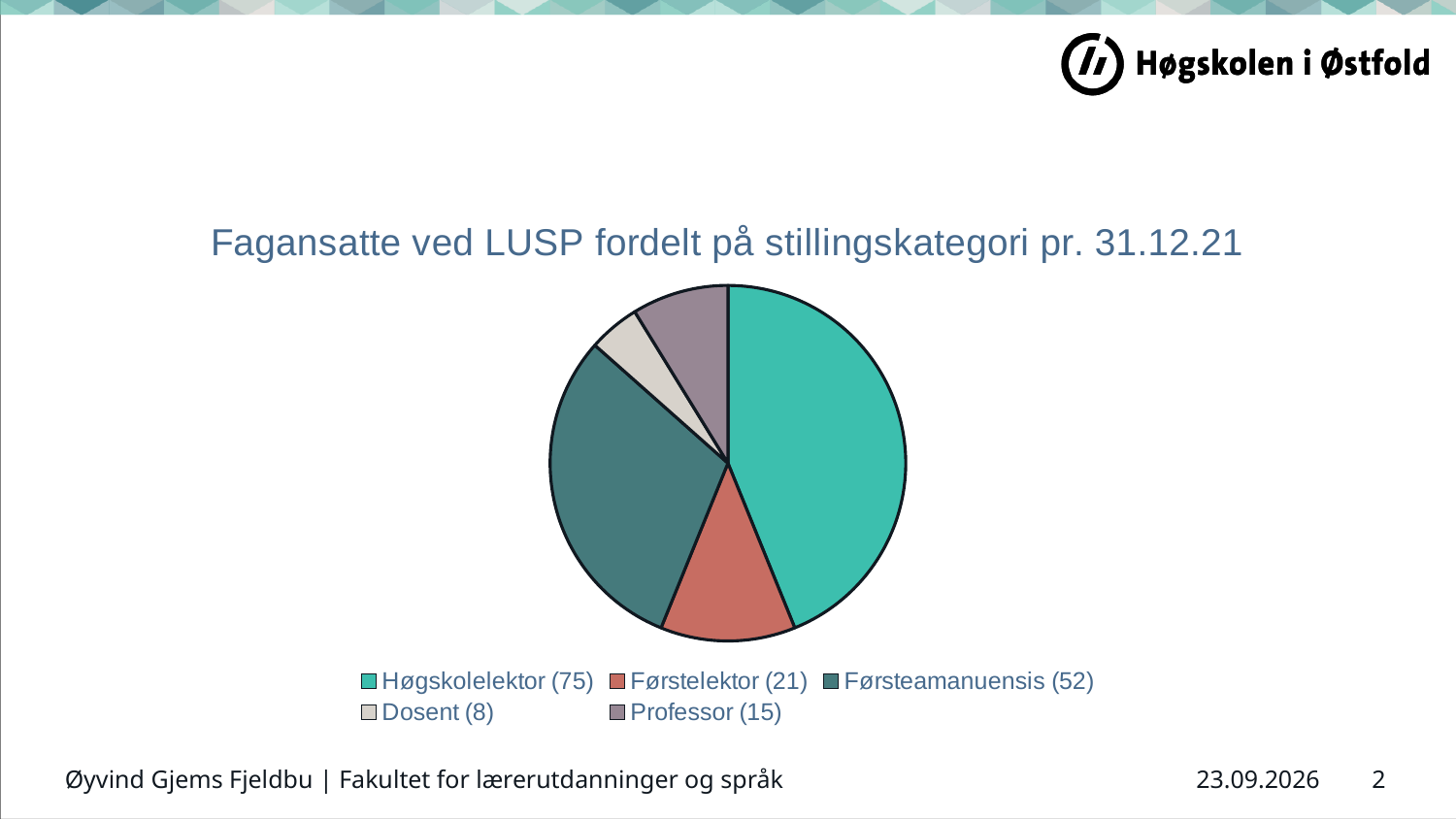
How many Høgskolelektor are shown in the chart? 75 What is the difference between the values for Førstelektor and Professor? 6 What is the difference between the values for Høgskolelektor and Førsteamanuensis? 23 What is the total number of employees across all categories in the chart? 171 What kind of chart is shown on the slide? pie chart How many categories does the pie chart have? 5 Which category has the largest slice of the pie? Høgskolelektor What is the value for Førsteamanuensis? 52 What is the value for Dosent? 8 What is the value for Professor? 15 Which category has the smallest slice of the pie? Dosent Which is larger, Førstelektor or Professor? Førstelektor